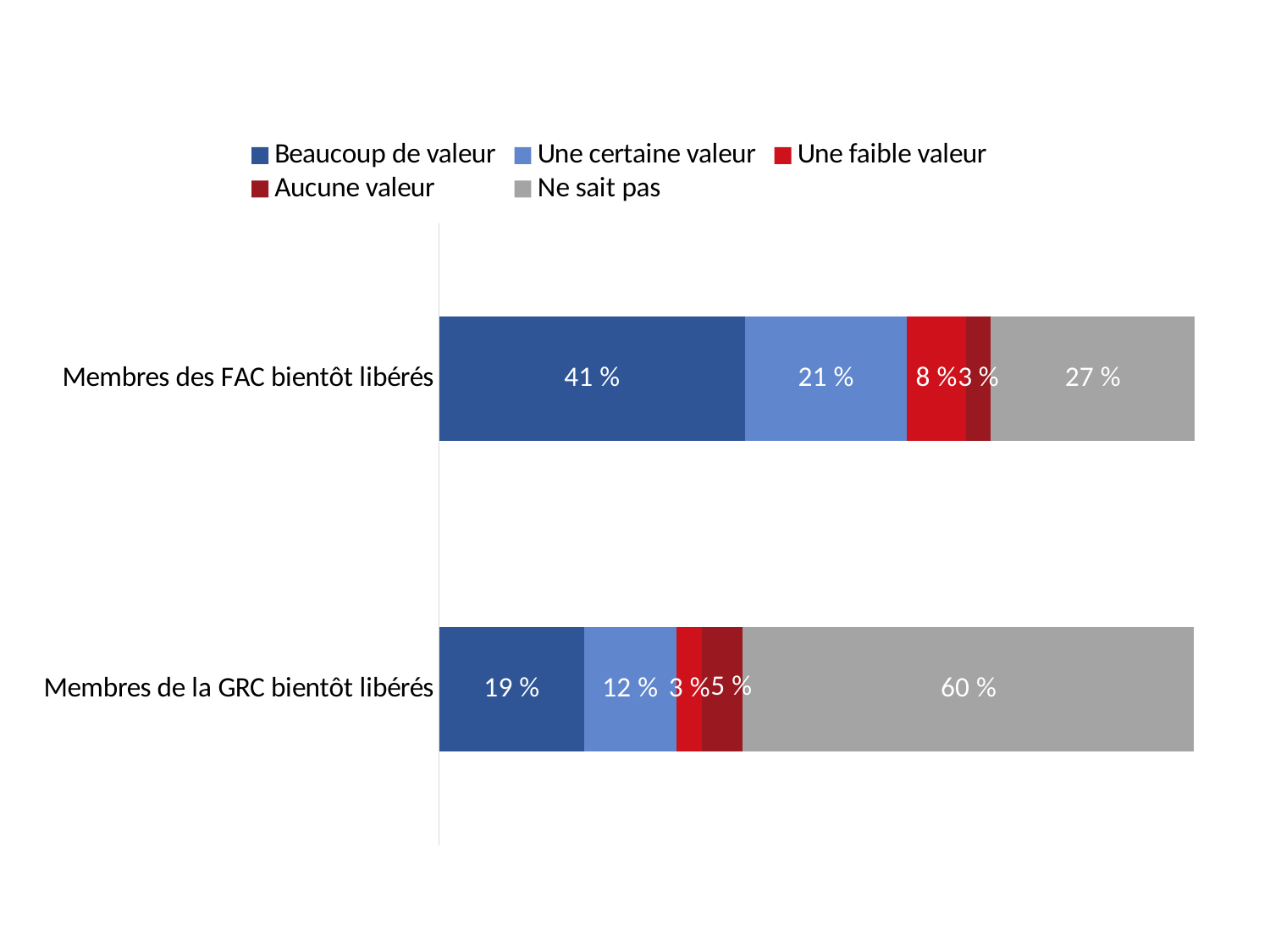
What is the value of "Ne sait pas" for "Membres de la GRC bientôt libérés"? 60 % How many series does the legend list? 5 What is the difference between the "Beaucoup de valeur" values for "Membres des FAC bientôt libérés" and "Membres de la GRC bientôt libérés"? 22 % What is the difference between the "Ne sait pas" values for "Membres de la GRC bientôt libérés" and "Membres des FAC bientôt libérés"? 33 % What is the value of "Une certaine valeur" for "Membres de la GRC bientôt libérés"? 12 % How many categories are plotted on the chart? 2 What kind of chart is shown on the slide? Stacked bar chart What is the value of "Aucune valeur" for "Membres des FAC bientôt libérés"? 3 % Which category has the higher value for "Beaucoup de valeur"? Membres des FAC bientôt libérés What is the value of "Beaucoup de valeur" for "Membres des FAC bientôt libérés"? 41 % Which series is shown in grey in the legend? Ne sait pas Which series is the largest segment in the bar for "Membres de la GRC bientôt libérés"? Ne sait pas